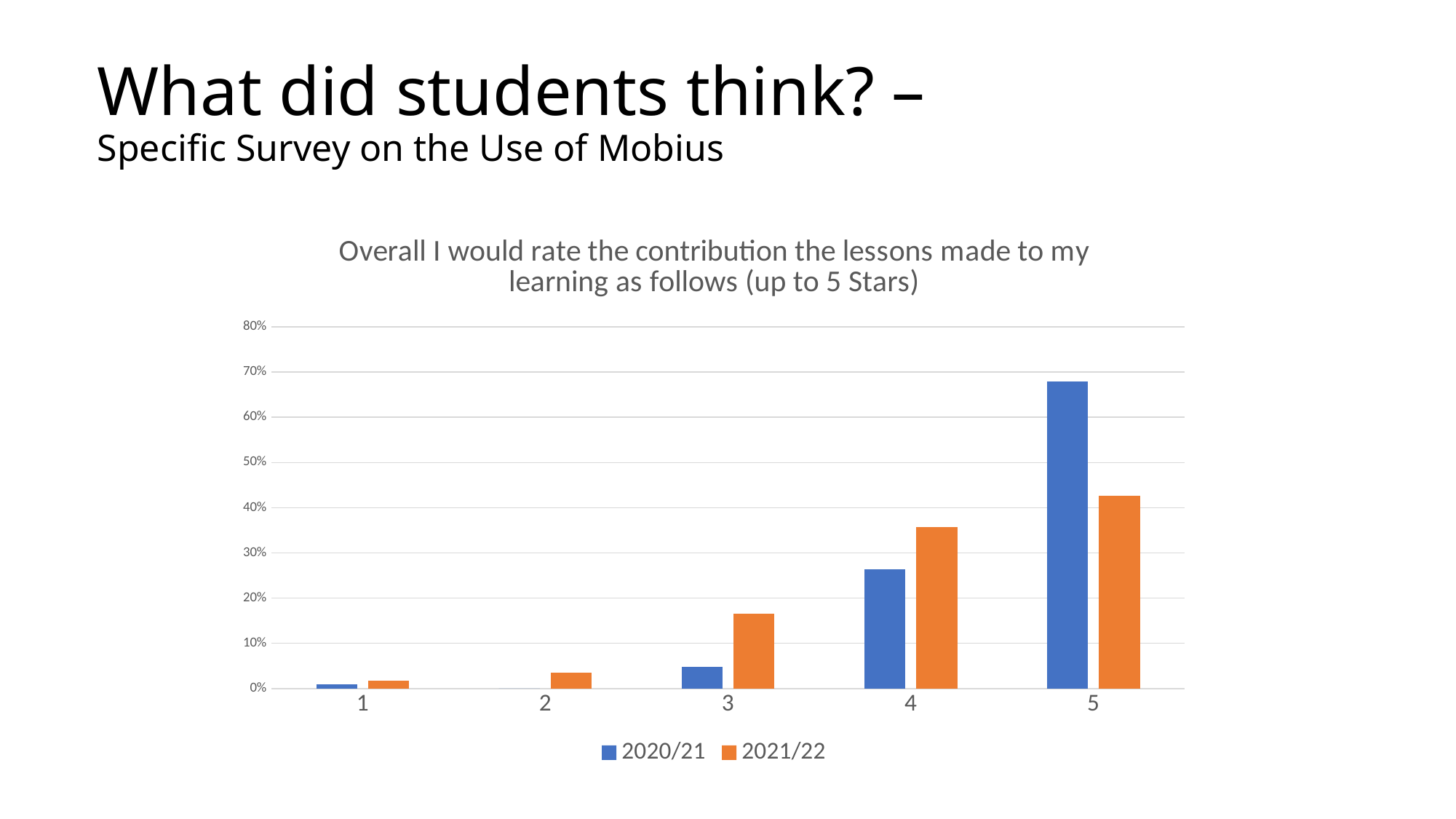
What kind of chart is shown on the slide? bar chart Is the 2020/21 value for rating 5 greater or less than 60%? greater Is the 2021/22 value for rating 5 greater or less than 50%? less Is the 2020/21 value for rating 4 greater or less than 30%? less Do the 2021/22 values rise or fall as the rating goes from 1 to 5? rise For rating 5, which series has the larger value, 2020/21 or 2021/22? 2020/21 Which rating has the lowest value for the 2020/21 series? 2 For rating 4, which series has the larger value, 2020/21 or 2021/22? 2021/22 Which rating has the highest value for the 2020/21 series? 5 Which rating has the highest value for the 2021/22 series? 5 How many series does the legend list? 2 How many rating categories are shown on the x axis? 5